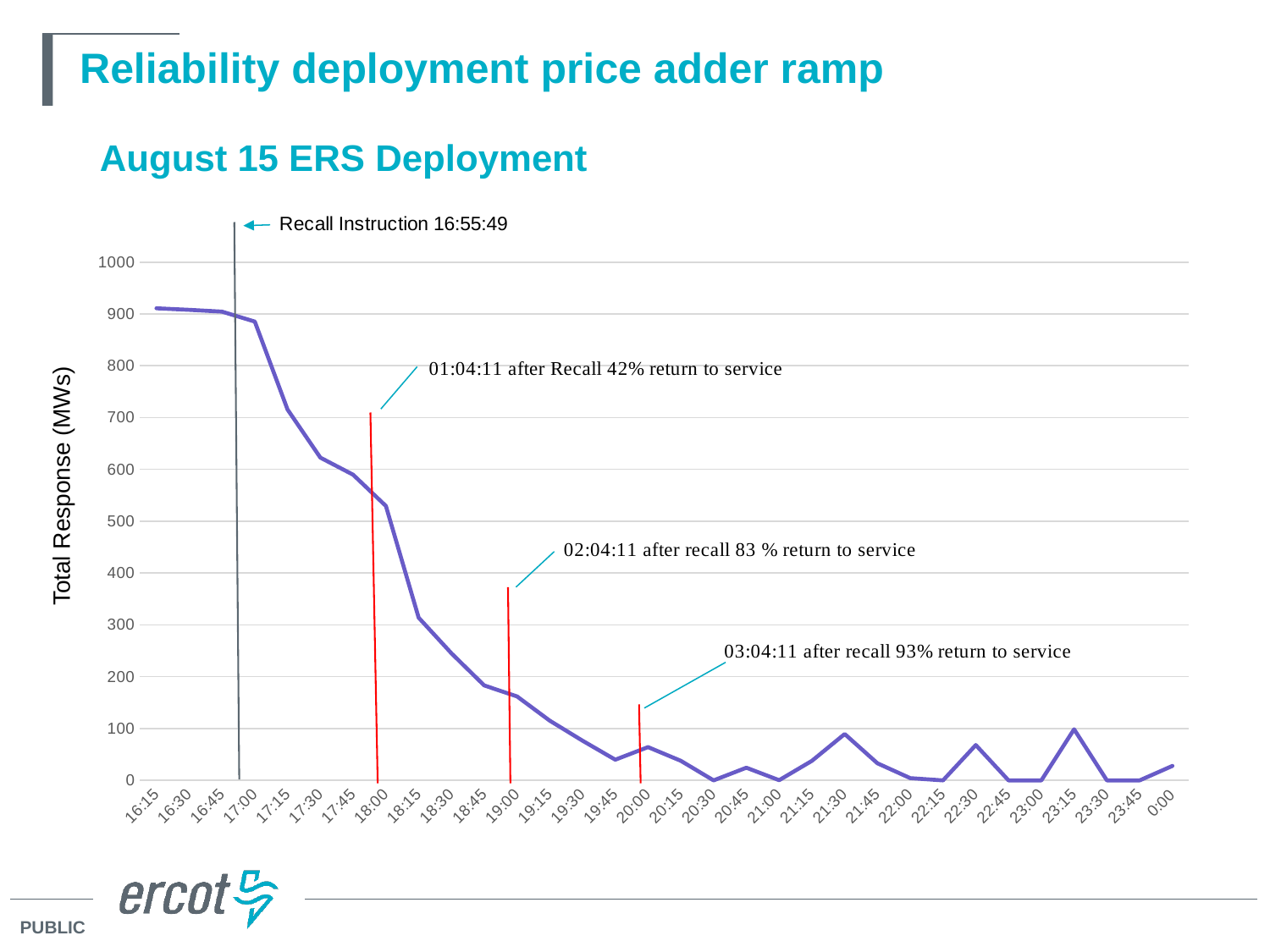
What kind of chart is shown on the slide? line chart Overall, does the Total Response rise or fall along the x axis from 16:15 to 0:00? fall Is the value for 19:00 greater or less than 200? less Is the value for 20:30 greater or less than 100? less Is the value for 18:00 greater or less than 500? greater Which has the larger value, 17:15 or 18:15? 17:15 What is the label on the y axis of the chart? Total Response (MWs) How many time labels are shown on the x axis? 32 What is the title of the chart? August 15 ERS Deployment